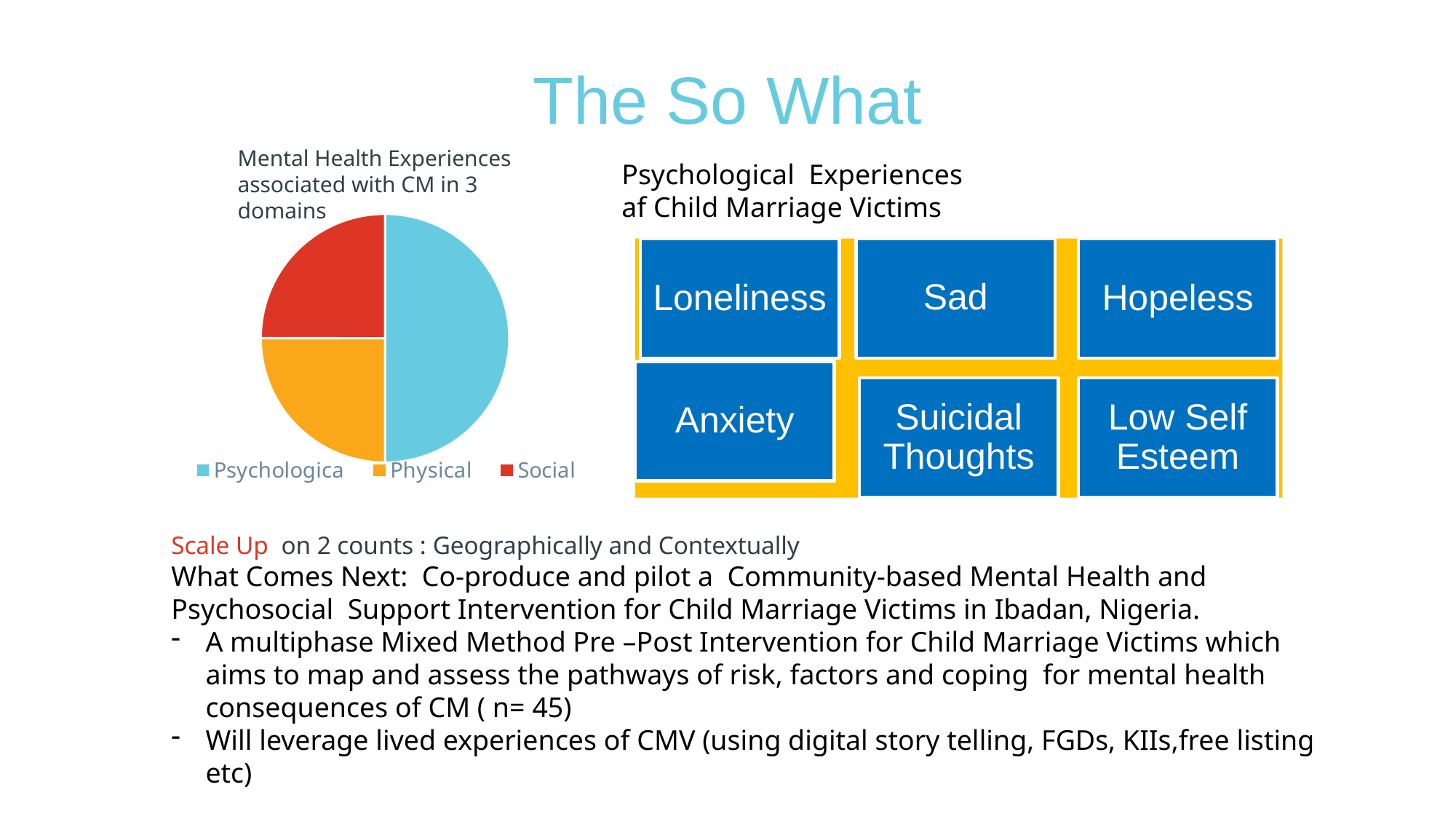
How many entries does the legend of the pie chart list? 3 Which slice is larger in the pie chart, Psychologica or Social? Psychologica Which slice is larger in the pie chart, Psychologica or Physical? Psychologica What colour is the Social slice in the pie chart? red Which domain has the largest slice in the pie chart? Psychologica What kind of chart is shown on the slide? pie chart What is the title of the pie chart? Mental Health Experiences associated with CM in 3 domains How many slices does the pie chart have? 3